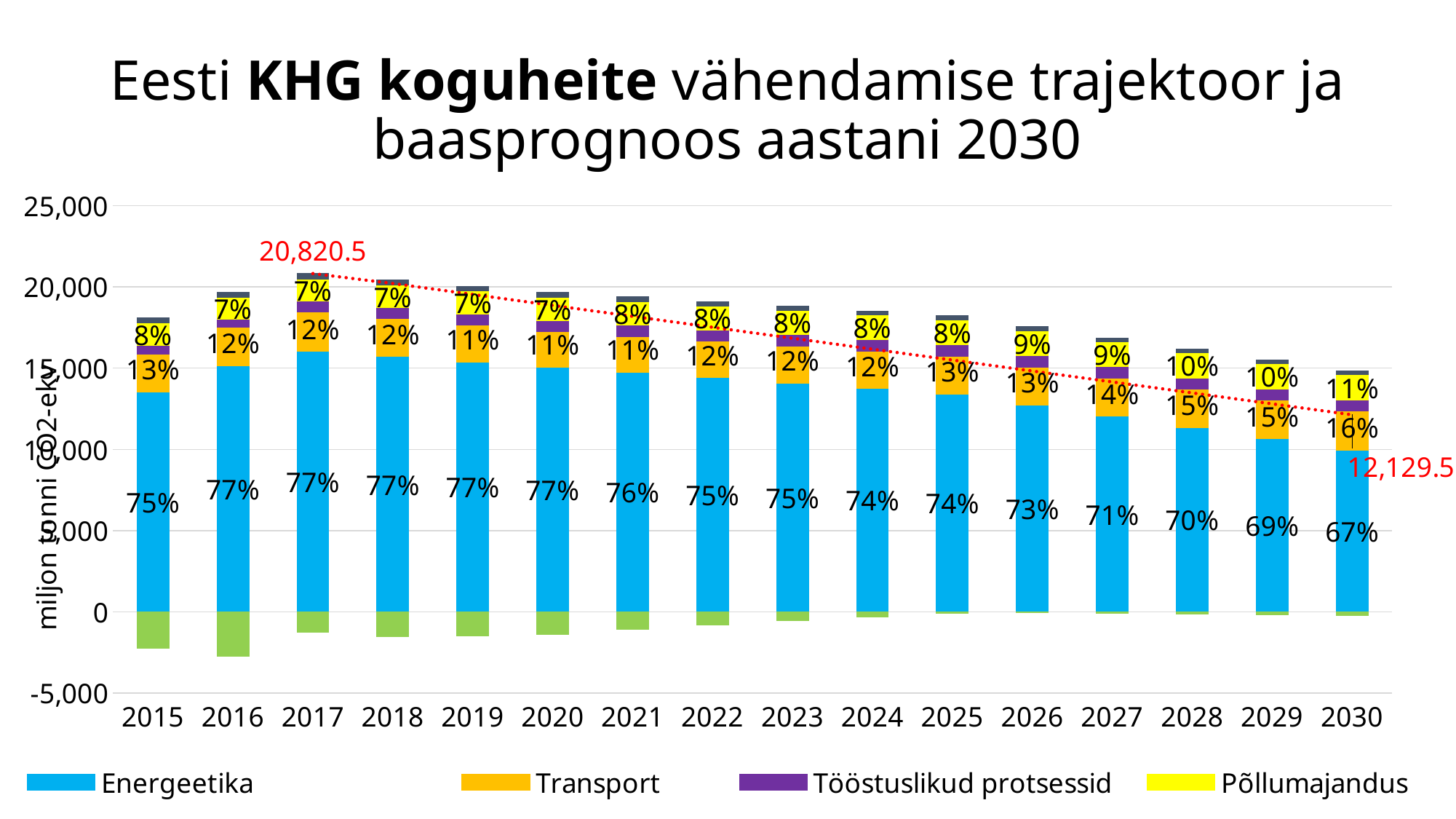
What value is labelled on the red dotted line at 2017? 20,820.5 By how many percentage points does the Energeetika share in 2015 exceed its share in 2030? 8 percentage points How many series does the legend list? 4 What percentage share does Energeetika have in 2015? 75% What percentage share does Transport have in 2030? 16% What percentage share does Energeetika have in 2030? 67% In which year is the Energeetika percentage share the lowest? 2030 Which year has a larger Transport share, 2015 or 2020? 2015 What percentage share does Põllumajandus have in 2017? 7% How many years are shown on the x axis? 16 In which year is the Transport percentage share the highest? 2030 What value is labelled on the red dotted line at 2030? 12,129.5